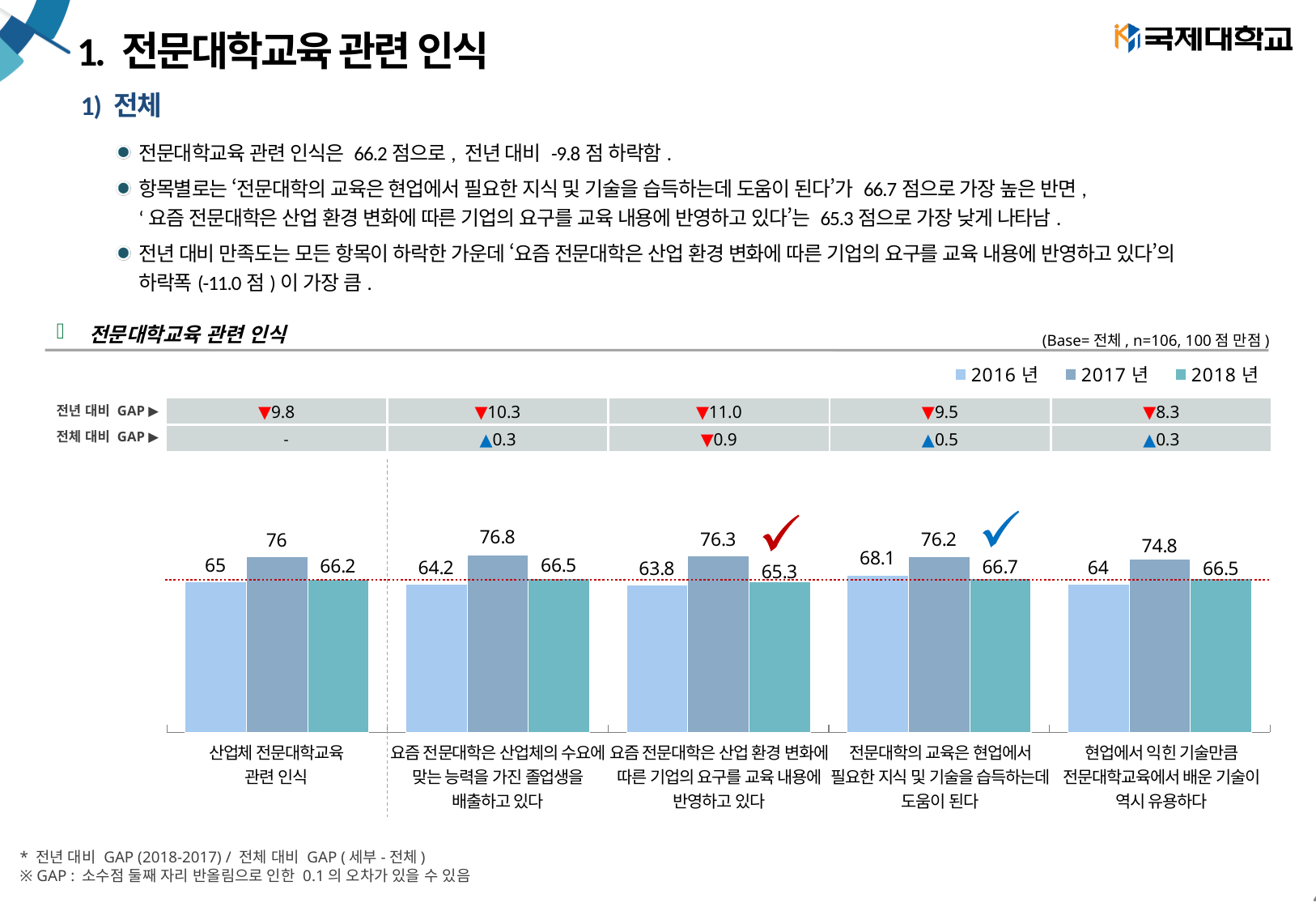
What kind of chart is shown on the slide? Bar chart Which category has the lowest 2016년 value? 요즘 전문대학은 산업 환경 변화에 따른 기업의 요구를 교육 내용에 반영하고 있다 How many series does the chart legend list? 3 What is the difference between the 2017년 and 2018년 values for '현업에서 익힌 기술만큼 전문대학교육에서 배운 기술이 역시 유용하다'? 8.3 What is the 2018년 value for '산업체 전문대학교육 관련 인식'? 66.2 What is the 전년 대비 GAP shown for '요즘 전문대학은 산업 환경 변화에 따른 기업의 요구를 교육 내용에 반영하고 있다'? ▼11.0 Which category has the lowest 2018년 value? 요즘 전문대학은 산업 환경 변화에 따른 기업의 요구를 교육 내용에 반영하고 있다 How many categories are shown on the x axis of the chart? 5 For '산업체 전문대학교육 관련 인식', which is larger: the 2016년 value or the 2018년 value? 2018년 What is the 2017년 value for '요즘 전문대학은 산업체의 수요에 맞는 능력을 가진 졸업생을 배출하고 있다'? 76.8 Which category has the highest 2018년 value? 전문대학의 교육은 현업에서 필요한 지식 및 기술을 습득하는데 도움이 된다 What is the 2016년 value for '전문대학의 교육은 현업에서 필요한 지식 및 기술을 습득하는데 도움이 된다'? 68.1